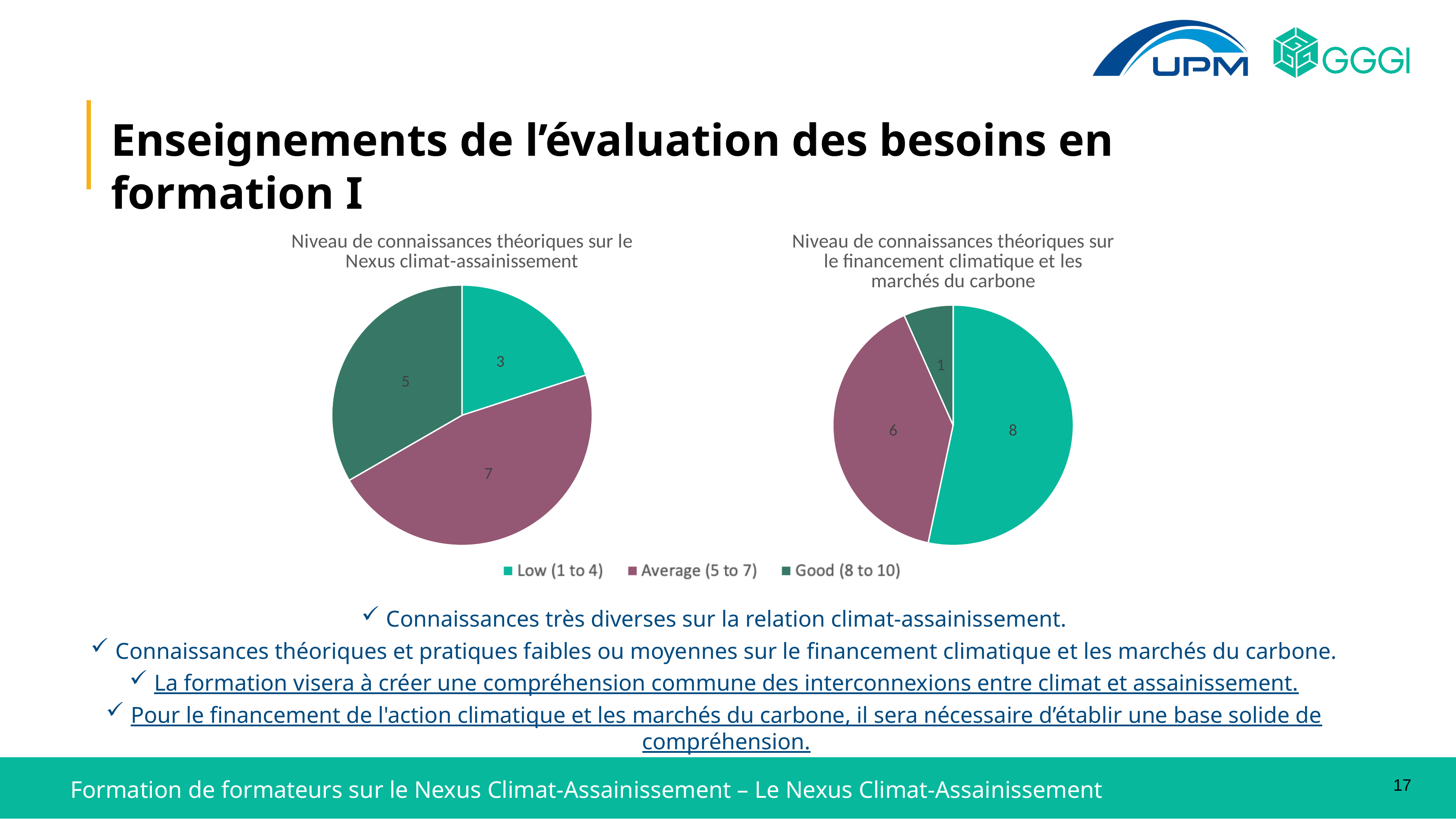
In the left pie chart (Nexus climat-assainissement), what is the value for Average (5 to 7)? 7 In the left pie chart (Nexus climat-assainissement), what share of the total does Low (1 to 4) represent? 20% In the left pie chart (Nexus climat-assainissement), what is the value for Good (8 to 10)? 5 What type of chart is used on this slide? Pie chart In the left pie chart (Nexus climat-assainissement), which category has the largest slice? Average (5 to 7) In the right pie chart (financement climatique et marchés du carbone), which is larger: Low (1 to 4) or Average (5 to 7)? Low (1 to 4) In the right pie chart (financement climatique et marchés du carbone), what share of the total does Average (5 to 7) represent? 40% In the left pie chart (Nexus climat-assainissement), what is the difference between the Average (5 to 7) and Low (1 to 4) values? 4 In the right pie chart (financement climatique et marchés du carbone), what is the difference between the Low (1 to 4) and Good (8 to 10) values? 7 In the right pie chart (financement climatique et marchés du carbone), what is the value for Low (1 to 4)? 8 In the right pie chart (financement climatique et marchés du carbone), which category has the smallest slice? Good (8 to 10) How many categories does the legend list for the pie charts? 3